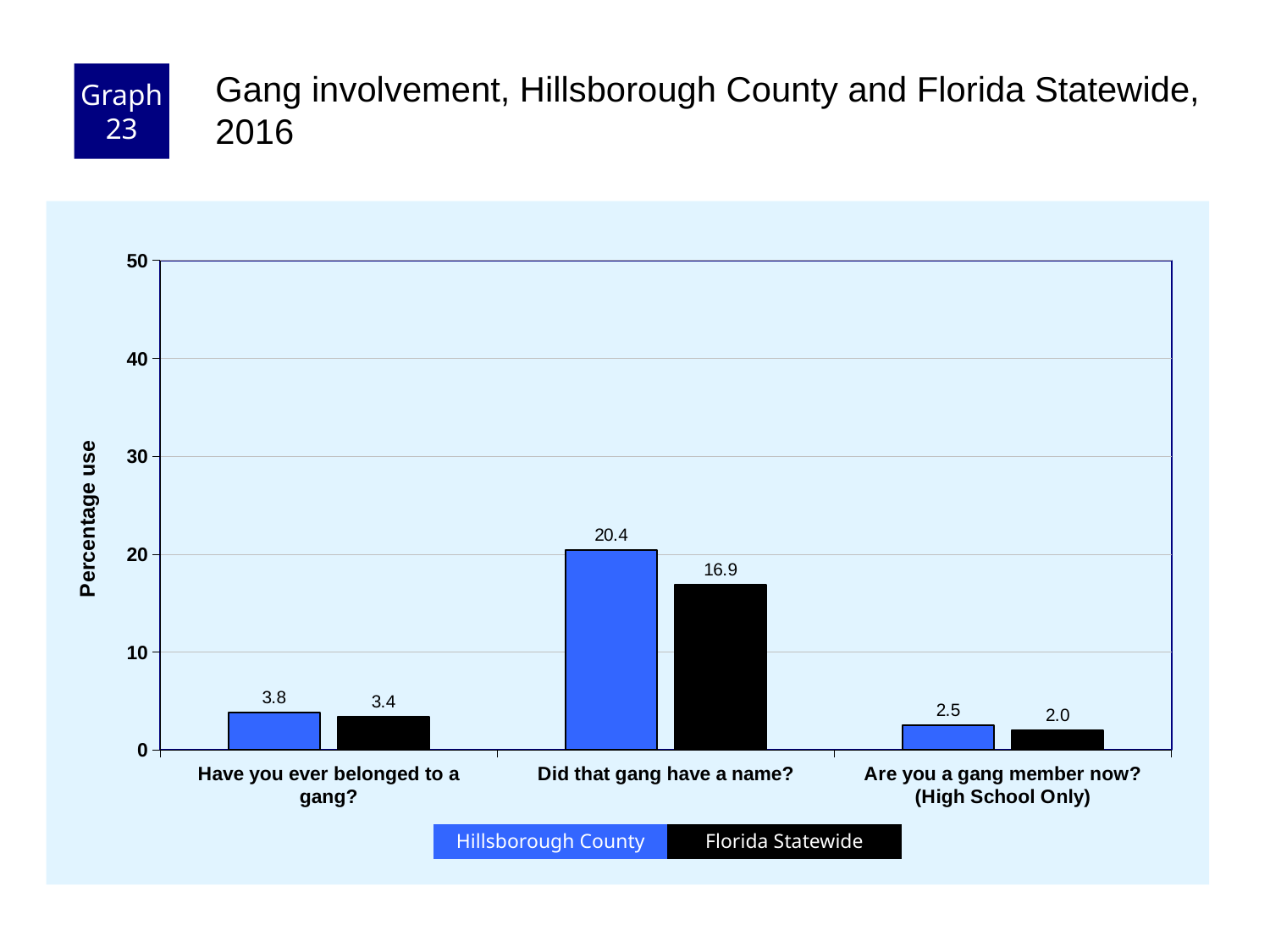
What kind of chart is shown on the slide? Bar chart Which question has the lowest Florida Statewide value? Are you a gang member now? (High School Only) What is the difference between the Hillsborough County and Florida Statewide values for "Did that gang have a name?"? 3.5 How many series does the legend list? 2 Is the Florida Statewide value for "Did that gang have a name?" greater or less than 20? less What is the difference between the Hillsborough County and Florida Statewide values for "Have you ever belonged to a gang?"? 0.4 What is the Hillsborough County value for "Did that gang have a name?"? 20.4 What is the Florida Statewide value for "Are you a gang member now? (High School Only)"? 2.0 Which question has the highest Hillsborough County value? Did that gang have a name? What is the Florida Statewide value for "Have you ever belonged to a gang?"? 3.4 For "Are you a gang member now? (High School Only)", which is larger: Hillsborough County or Florida Statewide? Hillsborough County How many question categories are shown on the x axis? 3